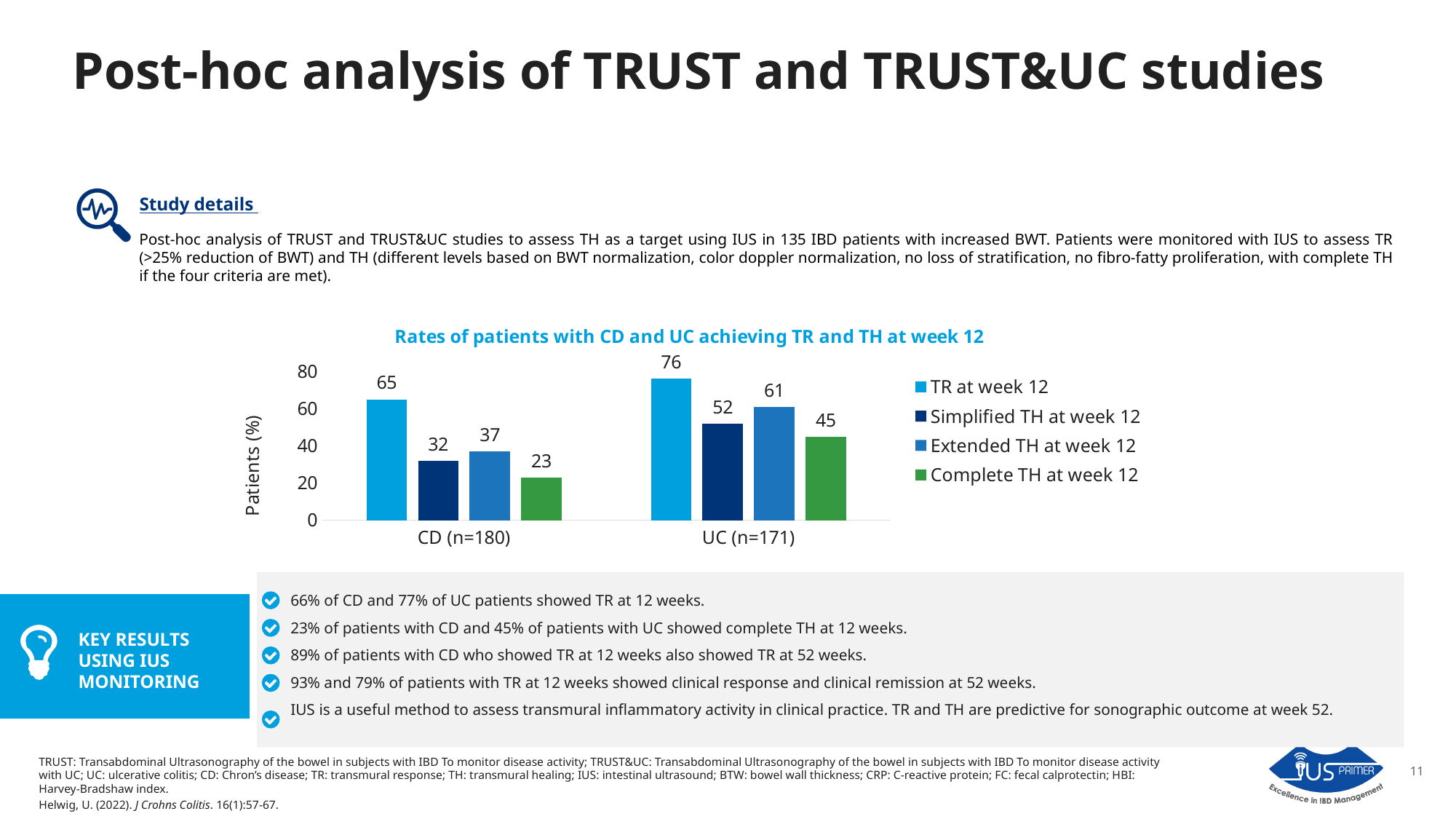
Which series has the lowest value in the CD (n=180) group? Complete TH at week 12 How many series does the legend list? 4 What is the value for TR at week 12 in the CD (n=180) group? 65 What is the value for Simplified TH at week 12 in the UC (n=171) group? 52 Which is larger: Complete TH at week 12 for CD (n=180) or for UC (n=171)? UC (n=171) What is the difference between Extended TH at week 12 and Simplified TH at week 12 in the CD (n=180) group? 5 How many patient groups are shown on the x axis? 2 What is the difference between TR at week 12 for UC (n=171) and CD (n=180)? 11 What is the title of the chart? Rates of patients with CD and UC achieving TR and TH at week 12 Which series has the highest value in the UC (n=171) group? TR at week 12 What kind of chart is shown on the slide? Bar chart What is the value for Complete TH at week 12 in the UC (n=171) group? 45